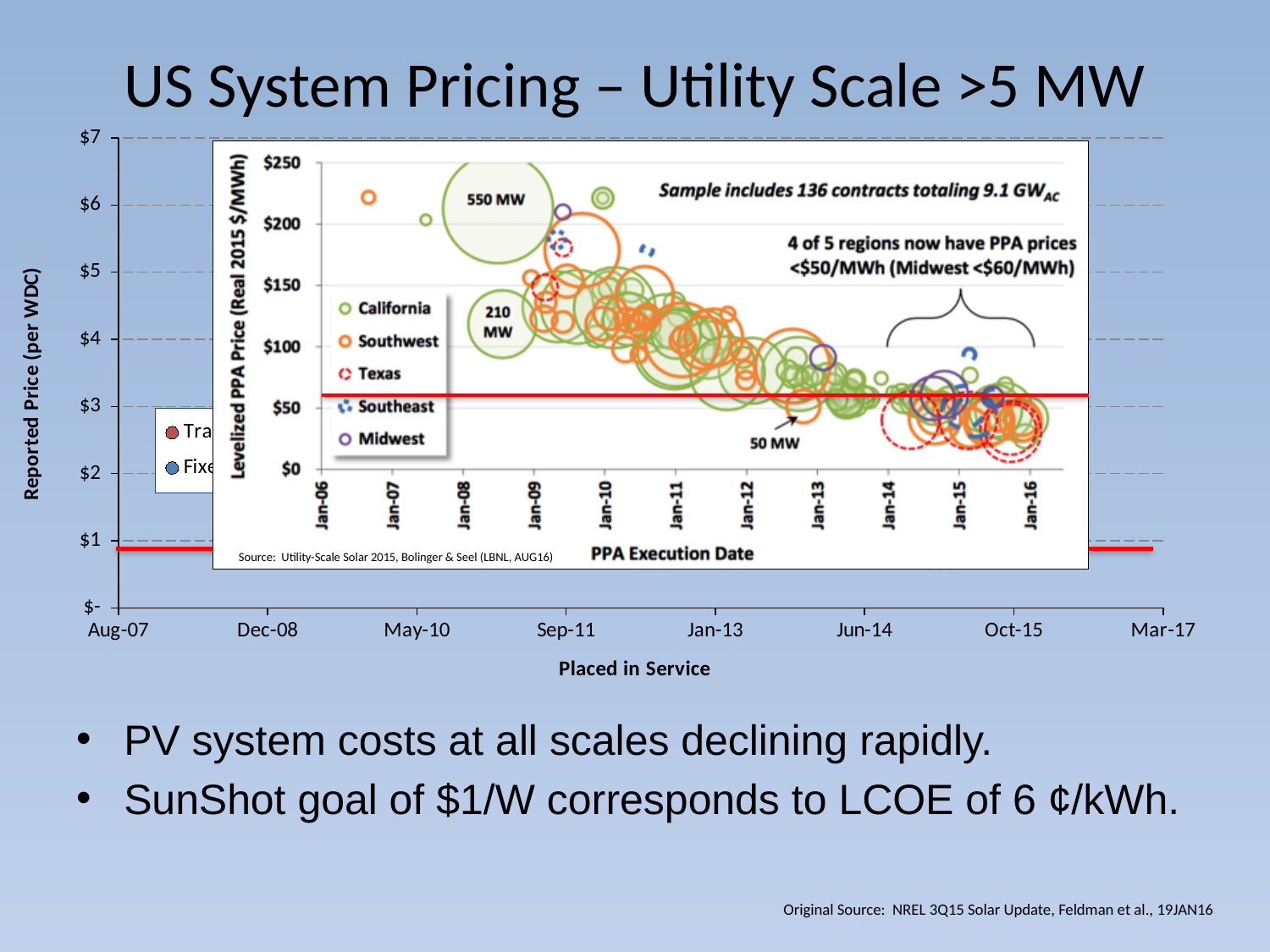
What is the x-axis label of the background chart on the slide? Placed in Service According to the inset PPA price chart, how many contracts does the sample include? 136 In the inset PPA price chart, is the levelized PPA price of the 50 MW bubble greater or less than $100? less According to the inset PPA price chart, what total capacity do the sampled contracts represent? 9.1 GWAC In the inset PPA price chart, which region does the 550 MW bubble belong to? California According to the annotation on the inset PPA price chart, how many of the 5 regions now have PPA prices below $50/MWh? 4 How many regions does the legend of the inset PPA price chart list? 5 In the inset PPA price chart, do levelized PPA prices rise or fall as the PPA execution date moves from Jan-06 to Jan-16? fall What is the highest value shown on the y-axis of the background Reported Price chart? $7 In the inset PPA price chart, is the levelized PPA price of the 550 MW bubble greater or less than $150? greater What kind of chart is the inset chart of Levelized PPA Price versus PPA Execution Date? bubble chart In the inset PPA price chart, which regions are listed in the legend? California, Southwest, Texas, Southeast, Midwest